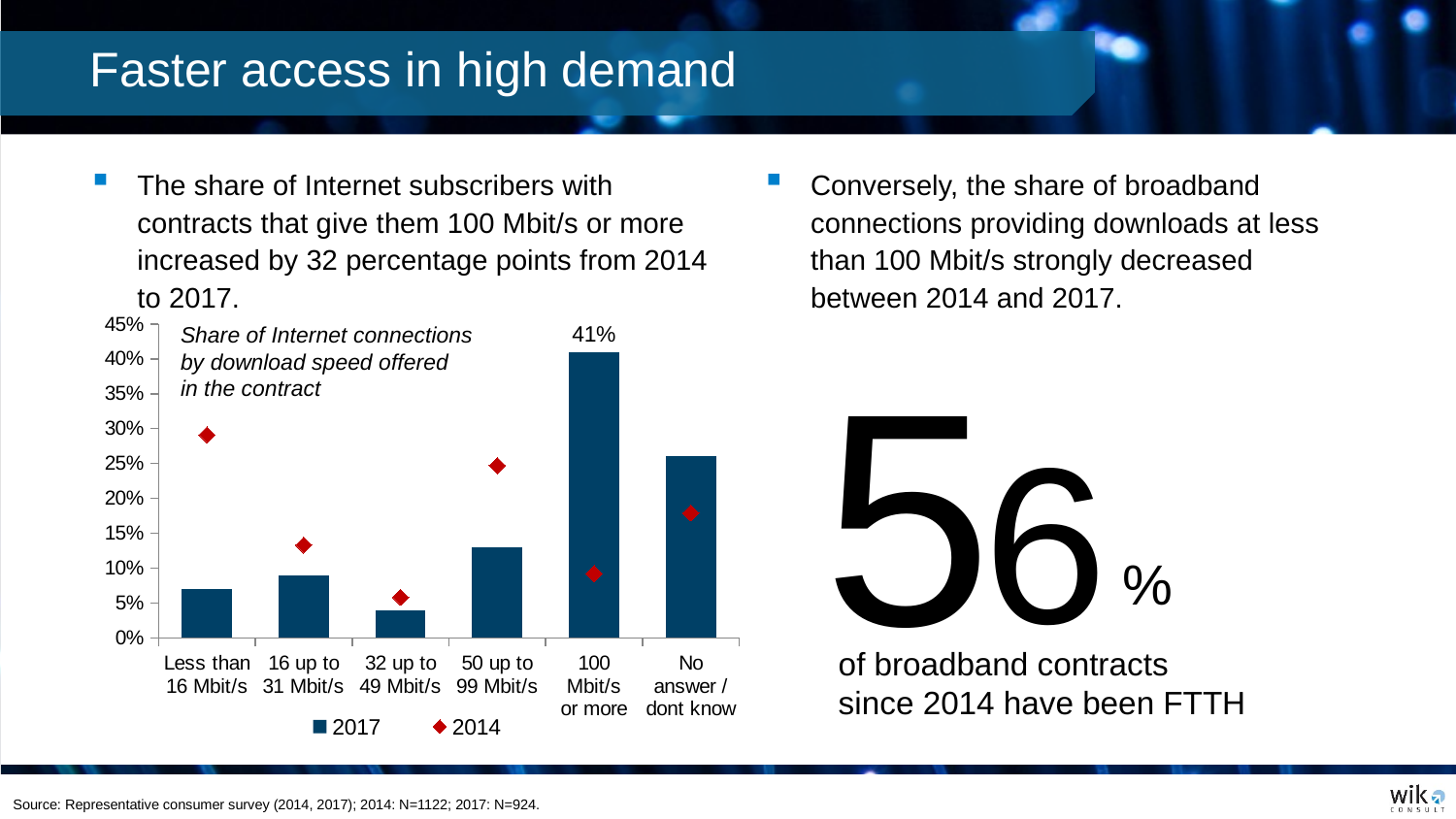
How many series does the legend list? 2 What kind of chart is used to show the 2017 values? Bar chart Which download speed category has the lowest 2017 share? 32 up to 49 Mbit/s For the 100 Mbit/s or more category, which year has the larger share, 2017 or 2014? 2017 Is the 2014 value for Less than 16 Mbit/s greater or less than 25%? greater For the Less than 16 Mbit/s category, which year has the larger share, 2017 or 2014? 2014 How many download speed categories are shown on the x axis? 6 Is the 2017 value for 50 up to 99 Mbit/s greater or less than 15%? less Which category has the lowest 2014 share? 32 up to 49 Mbit/s What is the 2017 share of Internet connections with 100 Mbit/s or more? 41% Which download speed category has the highest 2017 share? 100 Mbit/s or more Which category has the highest 2014 share? Less than 16 Mbit/s